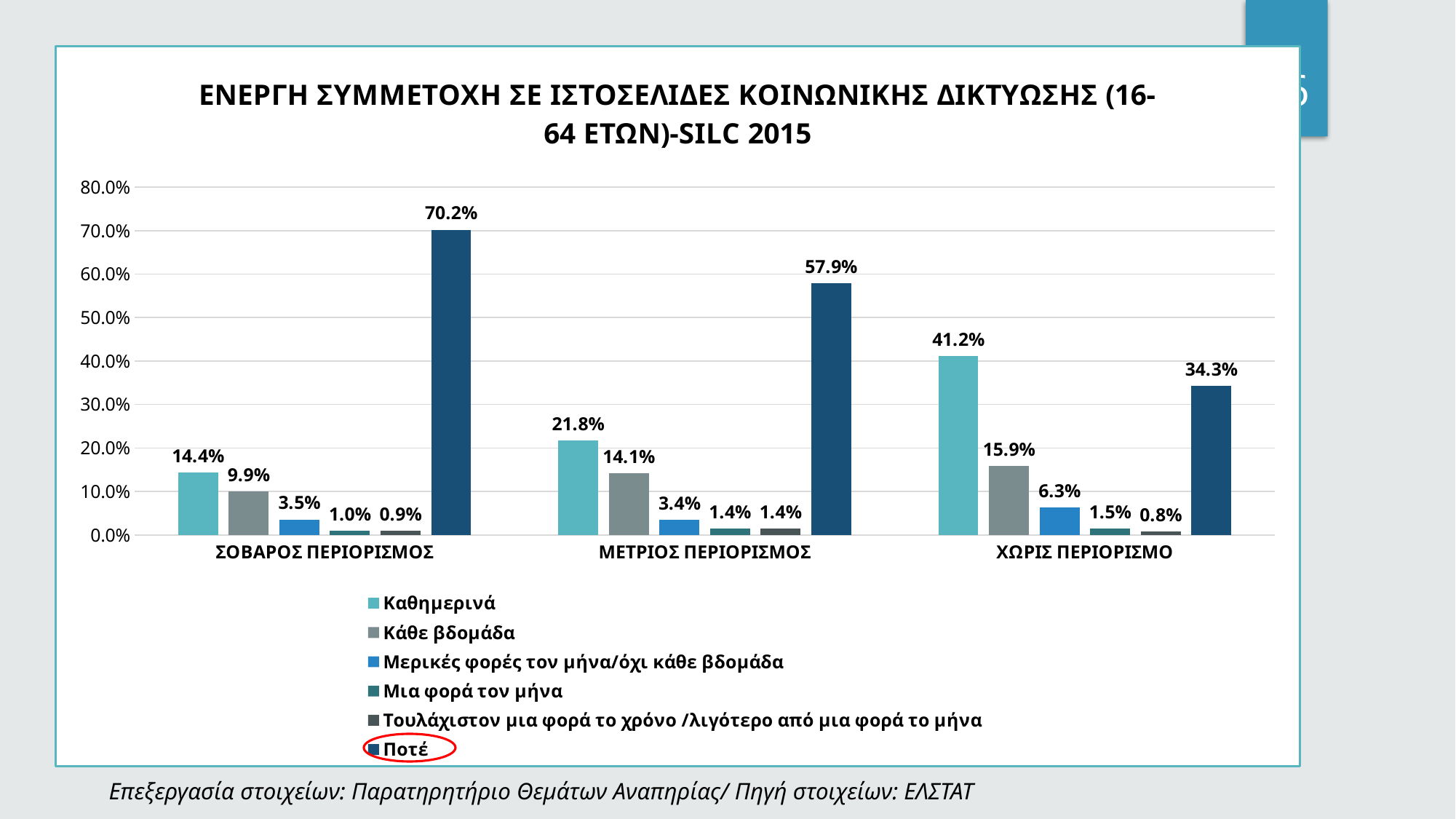
What is the value for Καθημερινά in the ΧΩΡΙΣ ΠΕΡΙΟΡΙΣΜΟ category? 41.2% What is the difference between the Ποτέ values for ΣΟΒΑΡΟΣ ΠΕΡΙΟΡΙΣΜΟΣ and ΧΩΡΙΣ ΠΕΡΙΟΡΙΣΜΟ? 35.9% How does the value for Ποτέ change across the categories from left to right? It falls What is the value for Κάθε βδομάδα in the ΜΕΤΡΙΟΣ ΠΕΡΙΟΡΙΣΜΟΣ category? 14.1% How many series does the legend list? 6 Which category has the highest value for Ποτέ? ΣΟΒΑΡΟΣ ΠΕΡΙΟΡΙΣΜΟΣ What is the value for Ποτέ in the ΣΟΒΑΡΟΣ ΠΕΡΙΟΡΙΣΜΟΣ category? 70.2% What kind of chart is shown on the slide? Bar chart Which legend entry is circled in red? Ποτέ Which is larger in the ΧΩΡΙΣ ΠΕΡΙΟΡΙΣΜΟ category: Καθημερινά or Ποτέ? Καθημερινά Which category has the lowest value for Καθημερινά? ΣΟΒΑΡΟΣ ΠΕΡΙΟΡΙΣΜΟΣ How many categories are shown on the x axis? 3